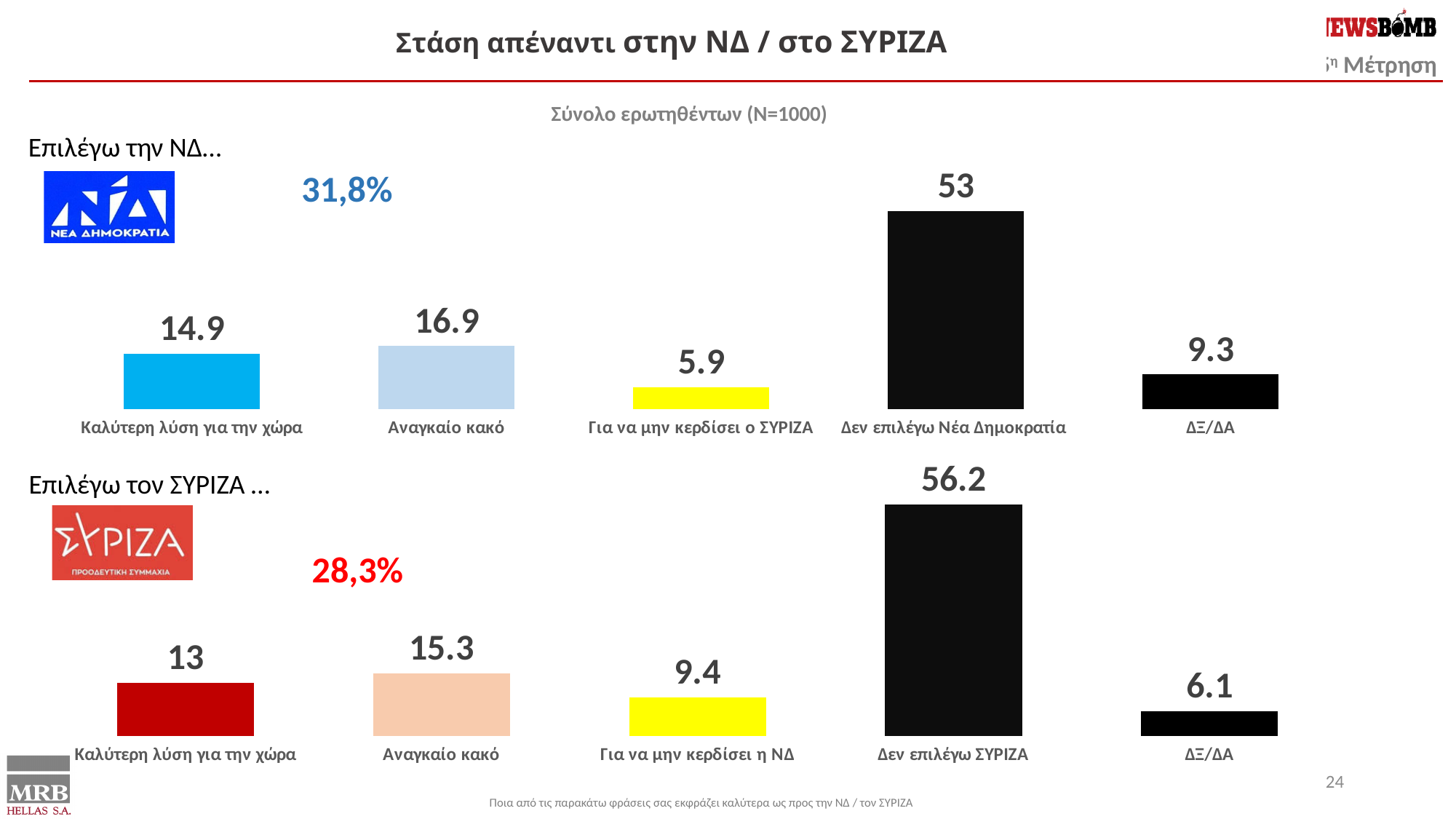
In the top chart (Επιλέγω την ΝΔ...), what is the difference between Αναγκαίο κακό and Καλύτερη λύση για την χώρα? 2 In the top chart (Επιλέγω την ΝΔ...), what is the value for Καλύτερη λύση για την χώρα? 14.9 In the bottom chart (Επιλέγω τον ΣΥΡΙΖΑ ...), what is the value for ΔΞ/ΔΑ? 6.1 How many categories does the top chart (Επιλέγω την ΝΔ...) show? 5 What type of chart is the bottom chart (Επιλέγω τον ΣΥΡΙΖΑ ...)? bar chart In the bottom chart (Επιλέγω τον ΣΥΡΙΖΑ ...), which category has the highest value? Δεν επιλέγω ΣΥΡΙΖΑ In the top chart (Επιλέγω την ΝΔ...), what is the value for Δεν επιλέγω Νέα Δημοκρατία? 53 In the top chart (Επιλέγω την ΝΔ...), which category has the lowest value? Για να μην κερδίσει ο ΣΥΡΙΖΑ In the bottom chart (Επιλέγω τον ΣΥΡΙΖΑ ...), what is the value for Αναγκαίο κακό? 15.3 What percentage is printed next to the ΣΥΡΙΖΑ logo in the bottom chart? 28,3% Which is larger: Για να μην κερδίσει ο ΣΥΡΙΖΑ in the top chart or Για να μην κερδίσει η ΝΔ in the bottom chart? Για να μην κερδίσει η ΝΔ in the bottom chart In the bottom chart (Επιλέγω τον ΣΥΡΙΖΑ ...), what is the difference between Δεν επιλέγω ΣΥΡΙΖΑ and Καλύτερη λύση για την χώρα? 43.2